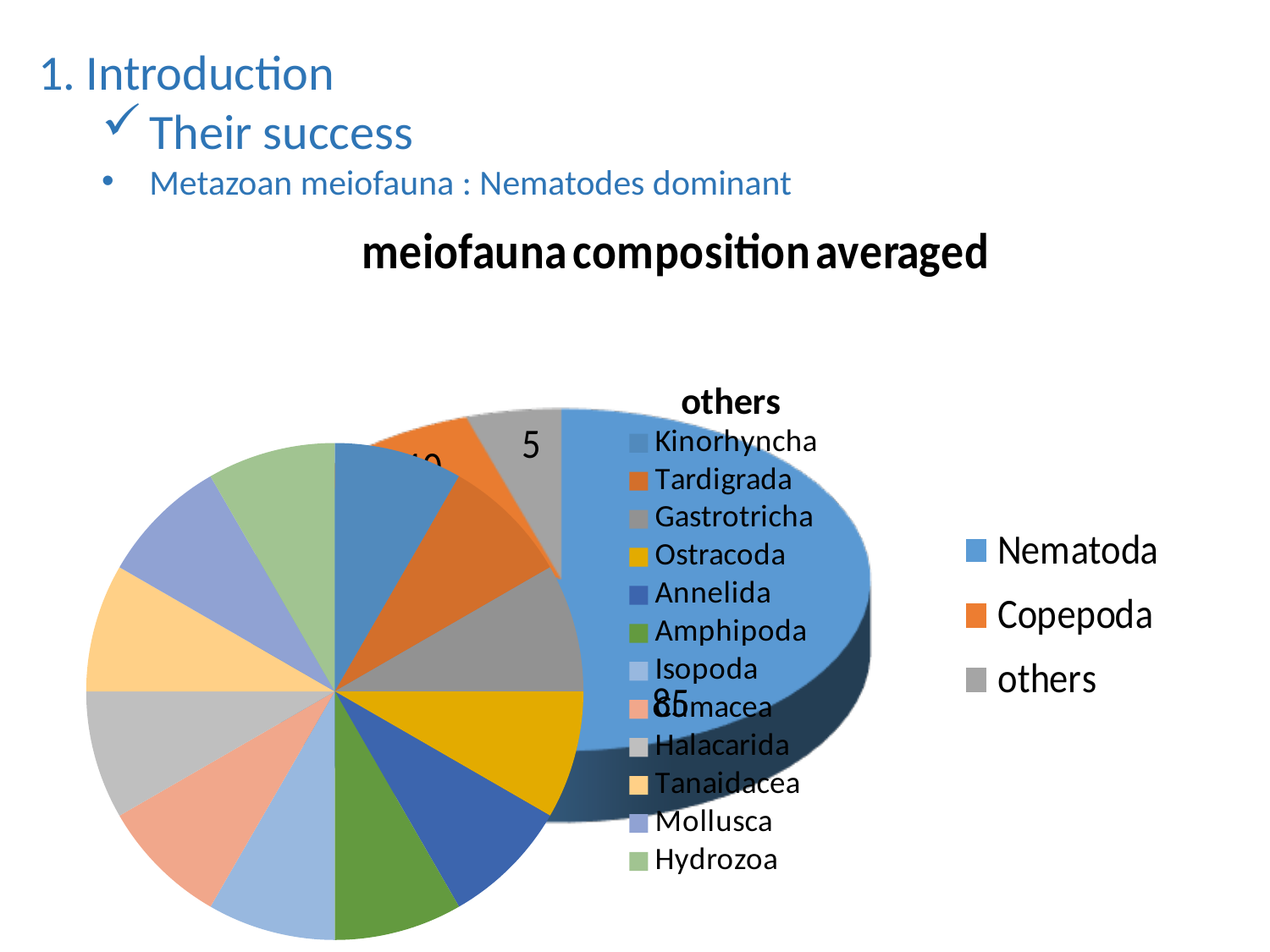
In the "meiofauna composition averaged" chart, which category has the smallest slice? others In the "meiofauna composition averaged" chart, what is the value for others? 5 How many categories does the legend of the "others" pie chart list? 12 What kind of chart is the "others" chart on the left of the slide? pie chart In the "meiofauna composition averaged" chart, which is larger, Nematoda or Copepoda? Nematoda In the "meiofauna composition averaged" chart, what is the value for Nematoda? 85 In the "meiofauna composition averaged" chart, what colour is the Nematoda slice? blue In the "meiofauna composition averaged" chart, what is the difference between the values for Nematoda and others? 80 How many entries does the legend of the "meiofauna composition averaged" chart list? 3 In the "meiofauna composition averaged" chart, which category has the largest slice? Nematoda What kind of chart is the "meiofauna composition averaged" chart? pie chart What is the title of the 3D pie chart on the slide? meiofauna composition averaged